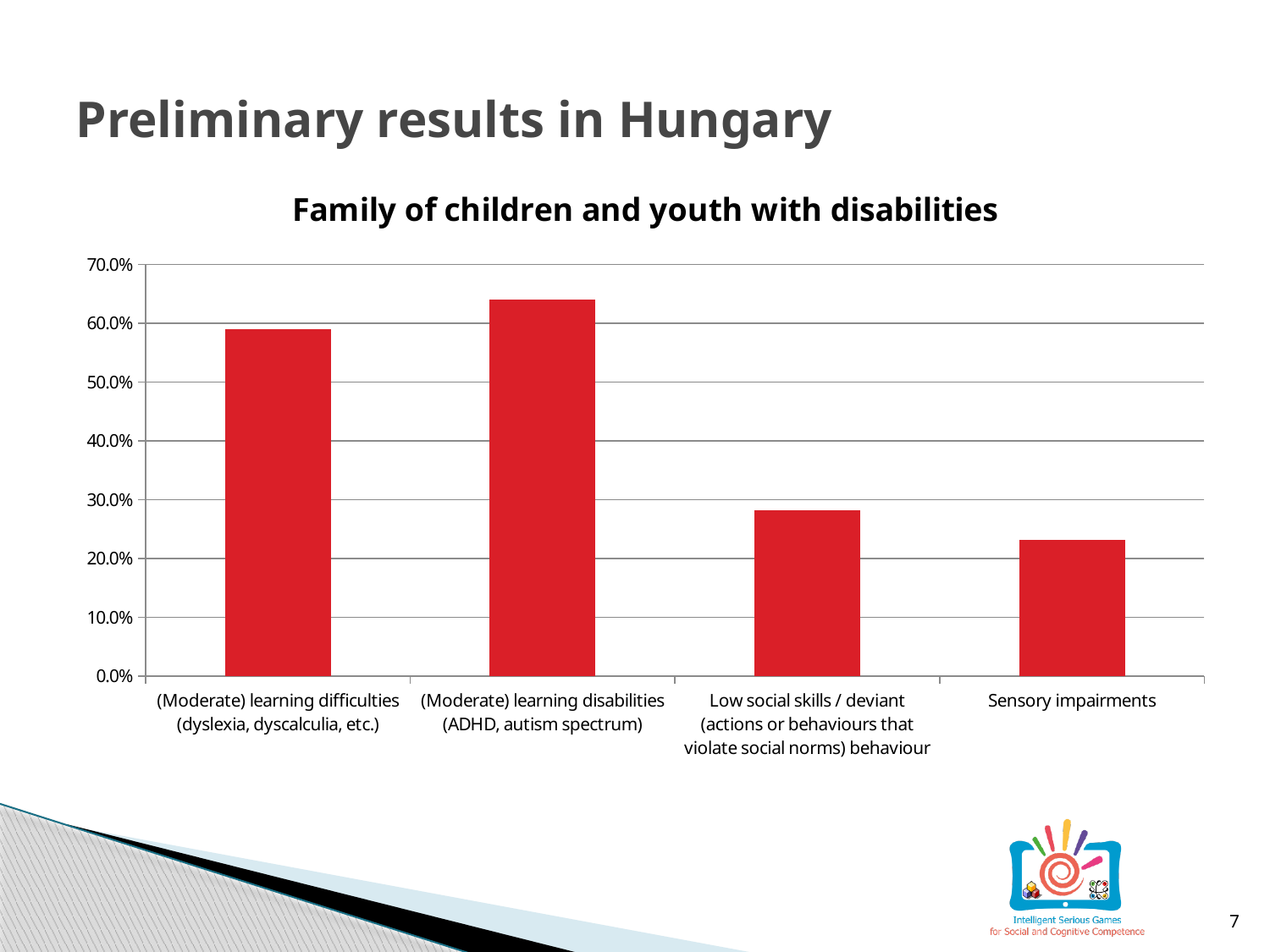
What is the title of the chart? Family of children and youth with disabilities What colour are the bars in the chart? red Which is larger: the value for (Moderate) learning difficulties or the value for (Moderate) learning disabilities? (Moderate) learning disabilities Is the value for Sensory impairments greater or less than 20.0%? greater Is the value for Low social skills / deviant behaviour greater or less than 30.0%? less Is the value for (Moderate) learning disabilities (ADHD, autism spectrum) greater or less than 60.0%? greater Which category has the highest value? (Moderate) learning disabilities (ADHD, autism spectrum) What kind of chart is shown on the slide? bar chart Which category has the lowest value? Sensory impairments How many categories are shown on the x axis of the chart? 4 Which is larger: the value for Low social skills / deviant behaviour or the value for Sensory impairments? Low social skills / deviant behaviour